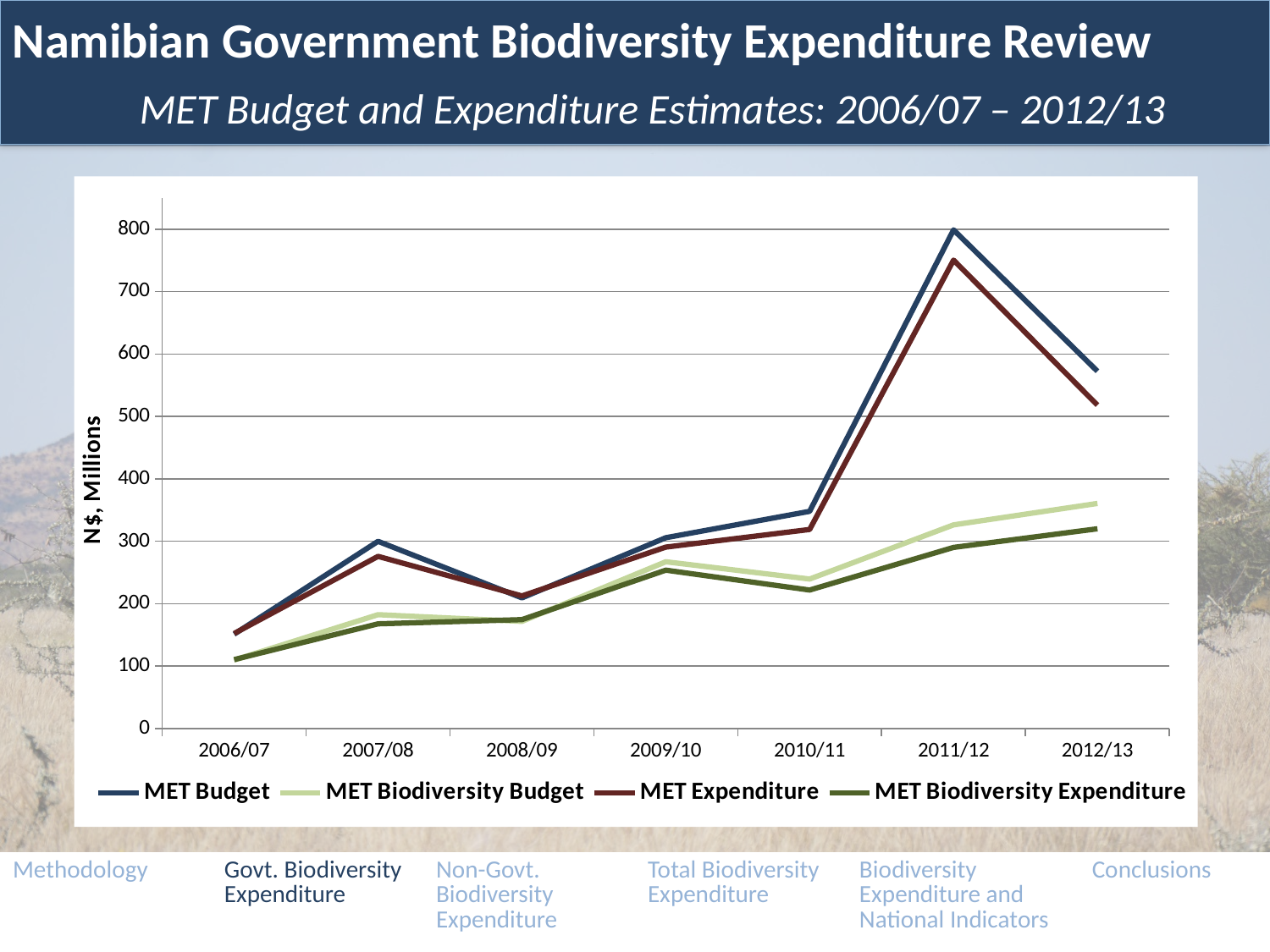
Is the value for MET Biodiversity Budget in 2012/13 greater or less than 400? less How many fiscal years are plotted along the x axis? 7 How many series does the legend list? 4 Is the value for MET Expenditure in 2011/12 greater or less than 700? greater Does the MET Budget series rise or fall between 2011/12 and 2012/13? fall What is the label on the y axis? N$, Millions In which year does the MET Budget series reach its highest value? 2011/12 Is the value for MET Biodiversity Expenditure in 2010/11 greater or less than 200? greater In which year is the MET Biodiversity Expenditure series at its lowest? 2006/07 What kind of chart is shown on the slide? line chart Which is larger in 2012/13: MET Budget or MET Expenditure? MET Budget